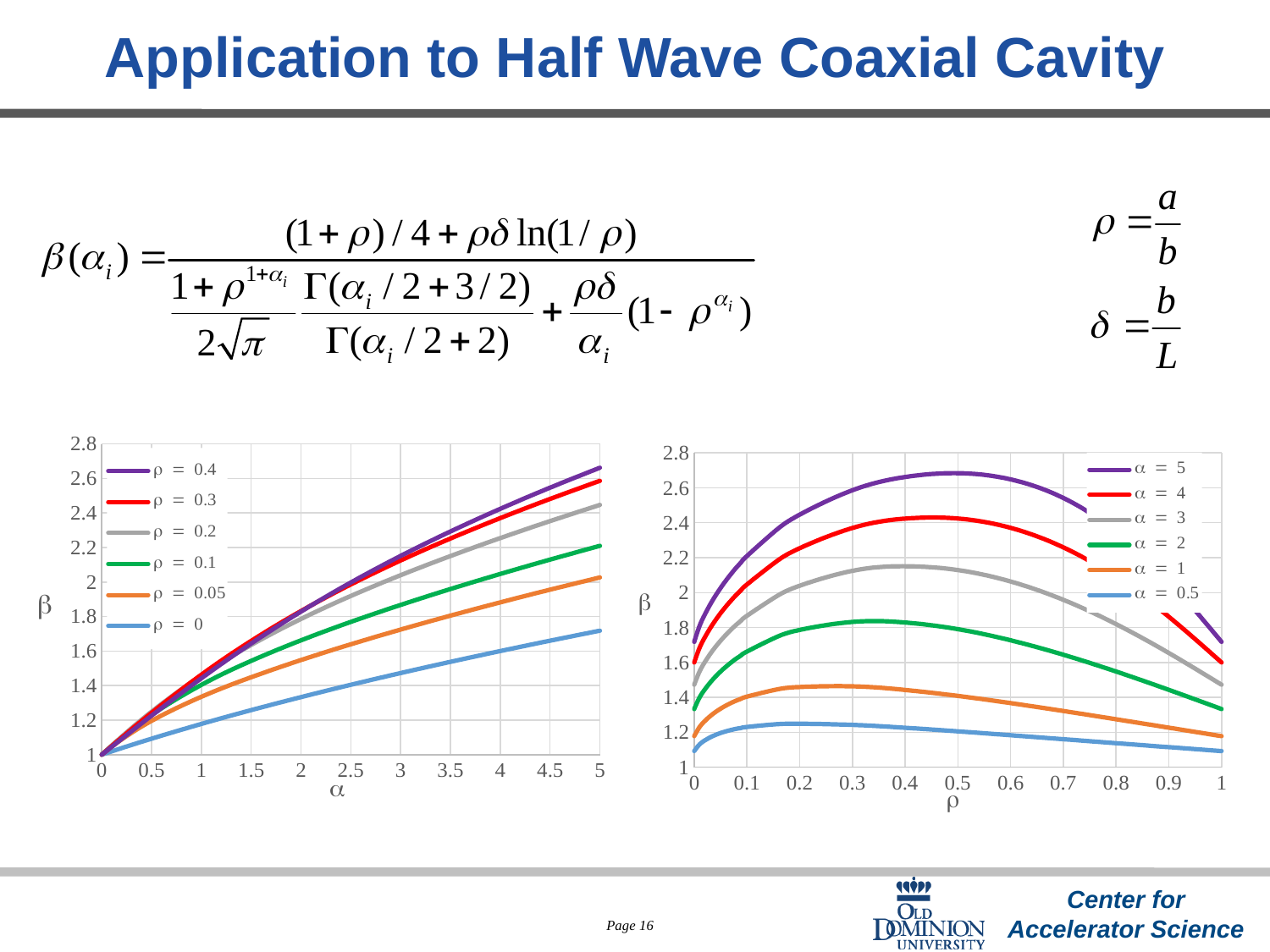
What is the label on the x axis of the right chart? ρ In the right chart (β versus ρ), is the peak value of the α = 0.5 curve greater or less than 1.4? less In the left chart (β versus α), is the value of the ρ = 0.4 curve at α = 5 greater or less than 2.4? greater In the left chart (β versus α), at α = 5, which curve has the larger β: ρ = 0.4 or ρ = 0? ρ = 0.4 In the right chart (β versus ρ), does the α = 3 curve rise or fall as ρ increases from 0.5 to 1? fall In the right chart (β versus ρ), which series has the lowest β values across the range? α = 0.5 How many series does the legend of the left chart (β versus α) list? 6 In the right chart (β versus ρ), which series reaches the highest β value? α = 5 How many series does the legend of the right chart (β versus ρ) list? 6 In the left chart (β versus α), is the value of the ρ = 0 curve at α = 5 greater or less than 2? less What kind of chart is the left chart (β versus α)? line chart In the left chart (β versus α), do the curves rise or fall as α increases from 0 to 5? rise